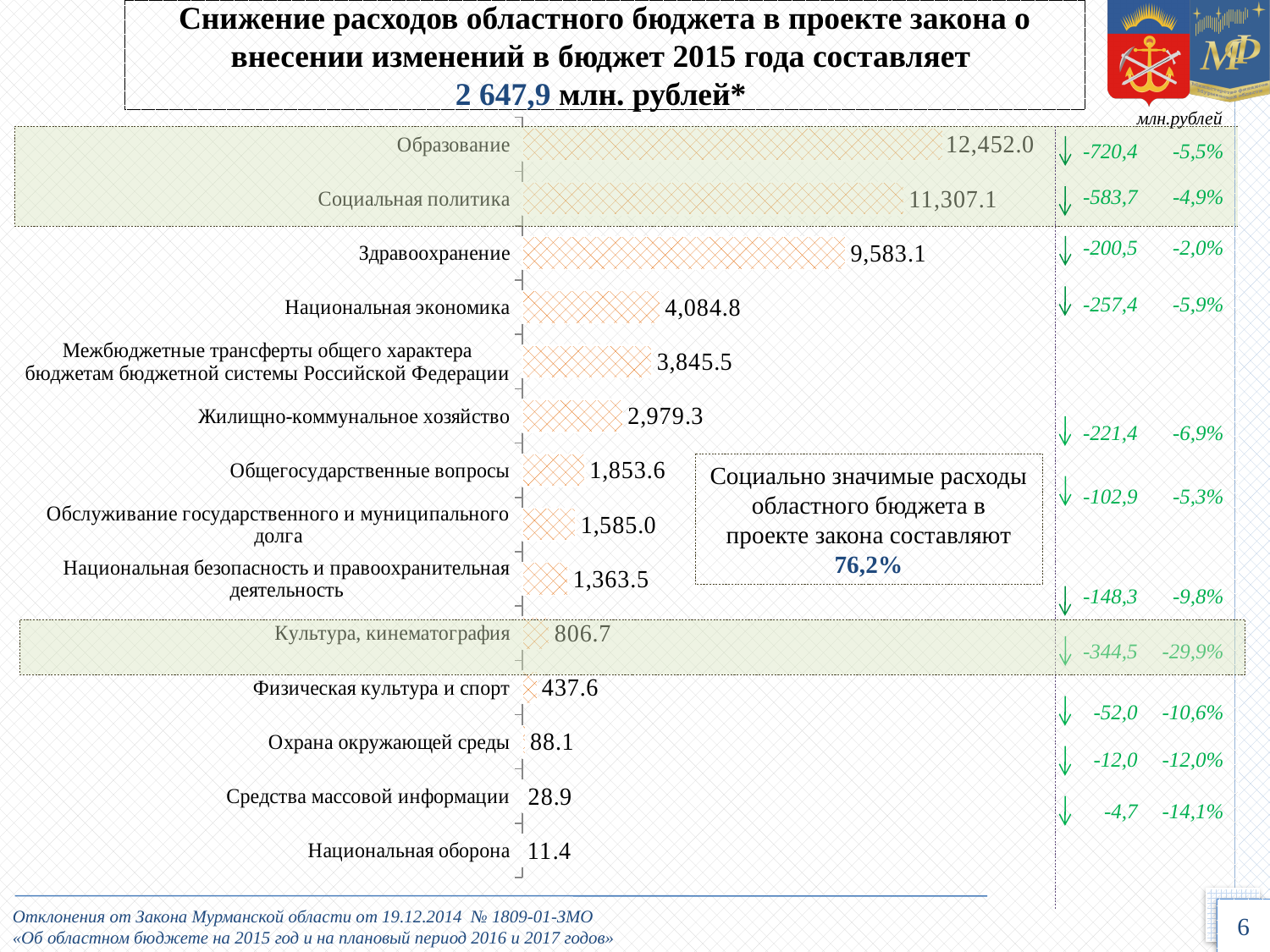
How many categories are shown in the chart? 14 What is the value for Жилищно-коммунальное хозяйство? 2,979.3 What is the difference between the values for Образование and Социальная политика? 1,144.9 What is the value for Средства массовой информации? 28.9 Which category has the highest value? Образование What kind of chart is shown on the slide? Bar chart What is the value for Культура, кинематография? 806.7 What is the difference between the values for Физическая культура и спорт and Охрана окружающей среды? 349.5 Which is larger, the value for Национальная экономика or the value for Межбюджетные трансферты общего характера бюджетам бюджетной системы Российской Федерации? Национальная экономика What is the value for Здравоохранение? 9,583.1 What is the value for Образование? 12,452.0 Which category has the lowest value? Национальная оборона